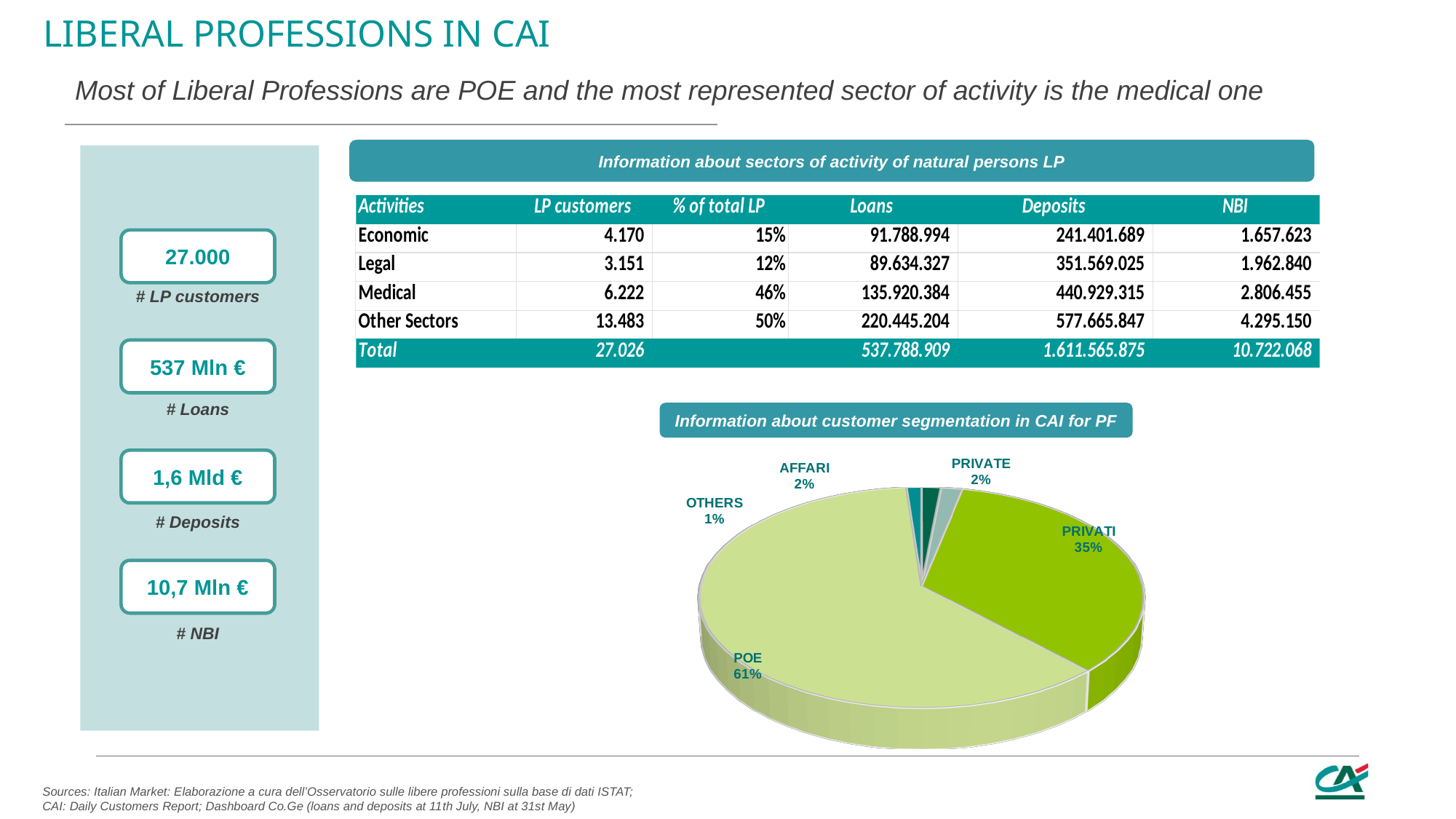
What is the title of the pie chart? Information about customer segmentation in CAI for PF Which segment has the largest slice in the pie chart? POE How many slices does the pie chart have? 5 In the pie chart, what share does PRIVATI have? 35% In the pie chart, what share does OTHERS have? 1% In the pie chart, what share does PRIVATE have? 2% What kind of chart is shown under the heading 'Information about customer segmentation in CAI for PF'? Pie chart Which segment has the smallest slice in the pie chart? OTHERS In the pie chart, what is the difference in percentage points between POE and PRIVATI? 26 In the pie chart, which is larger, PRIVATI or AFFARI? PRIVATI